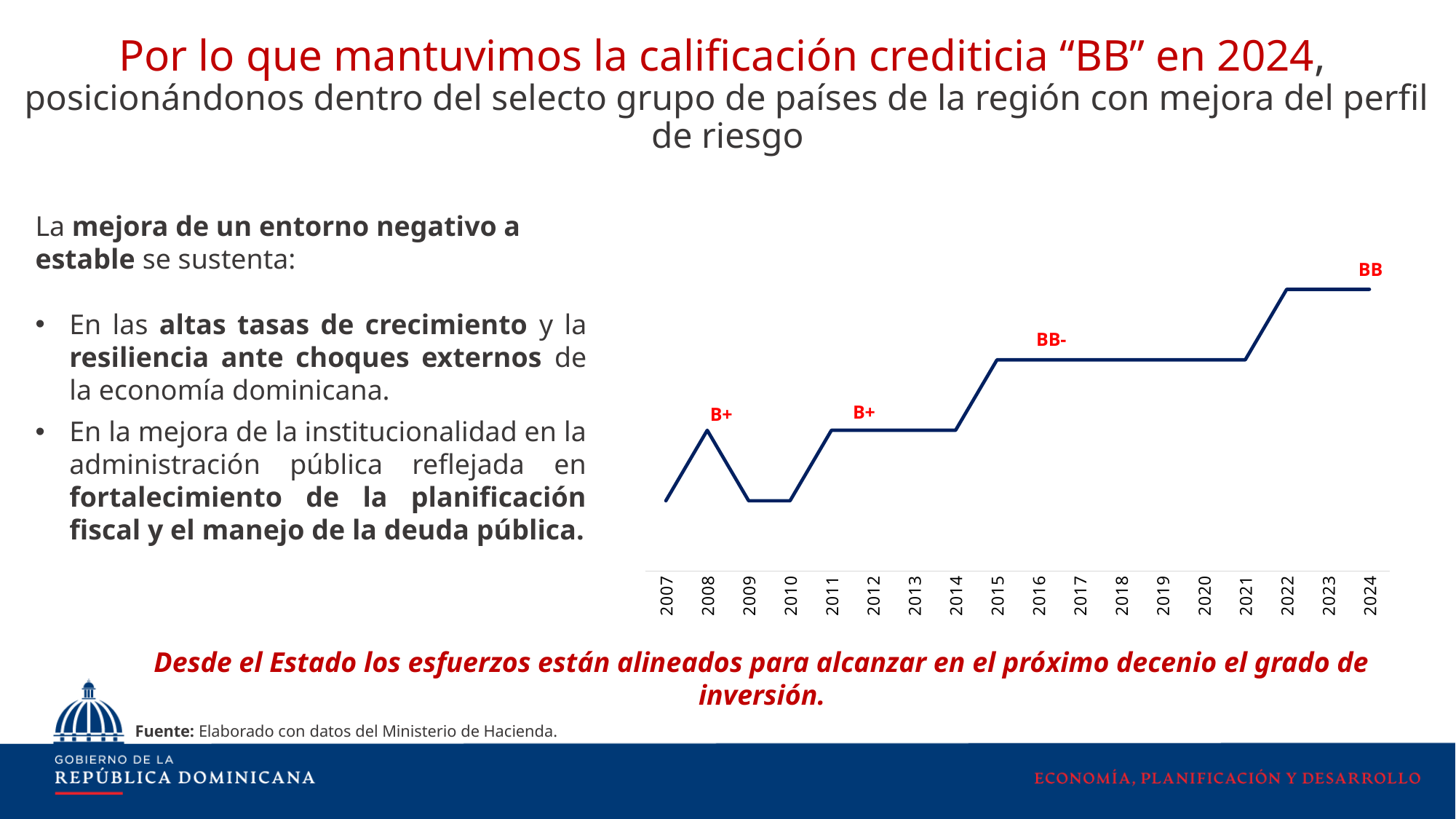
What credit rating is labelled for 2008 in the chart? B+ Which rating label is the highest reached on the chart? BB Does the line in the chart generally rise or fall from 2007 to 2024? rise Is the line higher in 2008 or in 2009? 2008 What credit rating is labelled for 2024 in the chart? BB What is the last year shown on the x axis of the chart? 2024 Which year has the lowest point on the line in the chart, 2009 or 2024? 2009 What kind of chart is shown on the slide? line chart What is the first year shown on the x axis of the chart? 2007 How many years are shown on the x axis of the chart? 18 What credit rating is labelled for 2015 in the chart? BB- Is the line higher in 2024 or in 2015? 2024